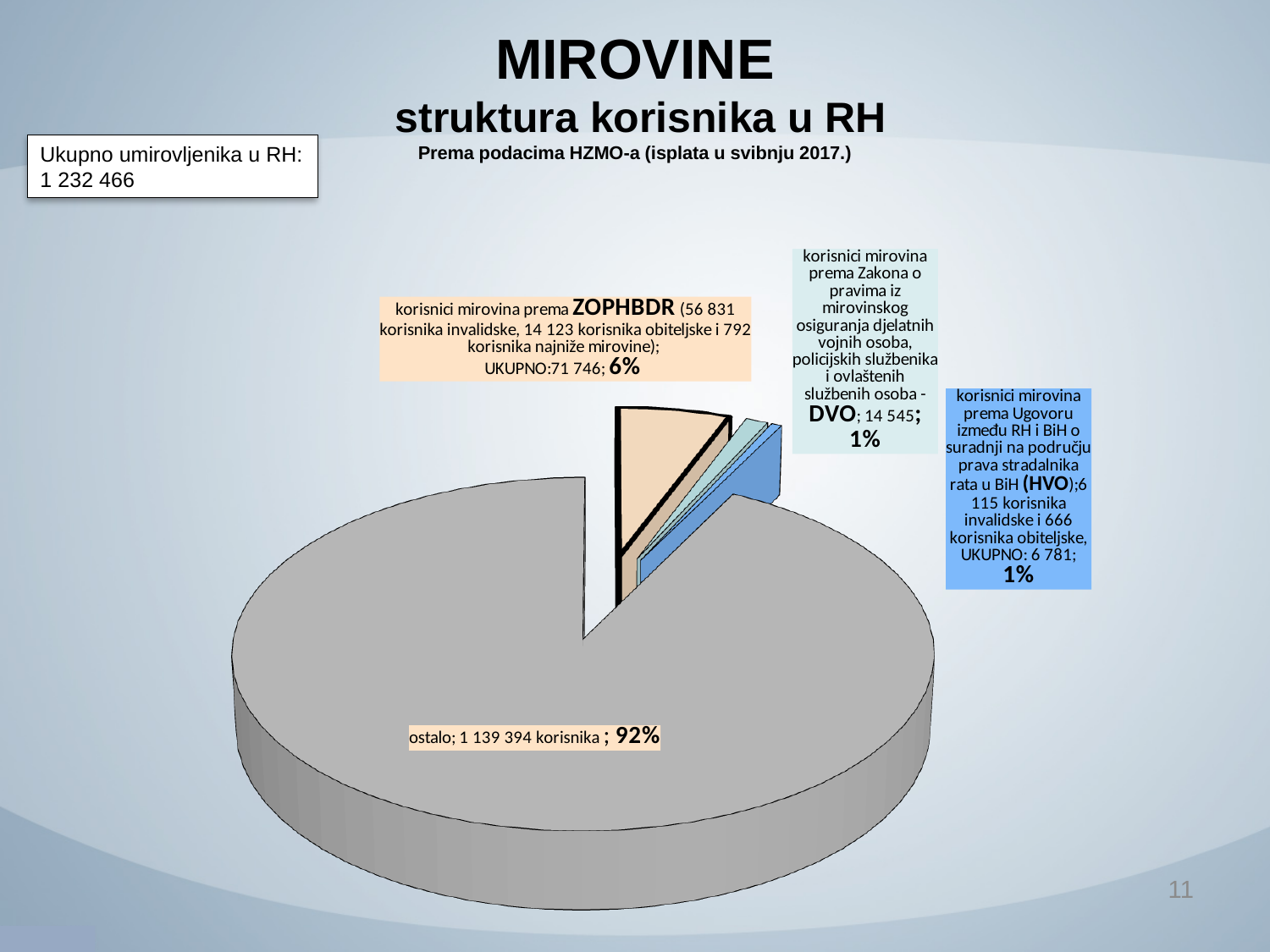
What is the value for the DVO slice? 14 545 What is the UKUPNO value for the HVO slice? 6 781 How many korisnika are in the 'ostalo' slice? 1 139 394 Which slice of the pie is the largest? ostalo Which is larger, the DVO slice or the HVO slice? DVO What kind of chart is shown on the slide? pie chart What is the UKUPNO value for korisnici mirovina prema ZOPHBDR? 71 746 What share of the pie does the ZOPHBDR slice represent? 6% What share of the pie does the 'ostalo' slice represent? 92% How many slices does the pie chart have? 4 Which slice of the pie is the smallest? HVO What is the difference between the ZOPHBDR total (71 746) and the DVO value (14 545)? 57 201